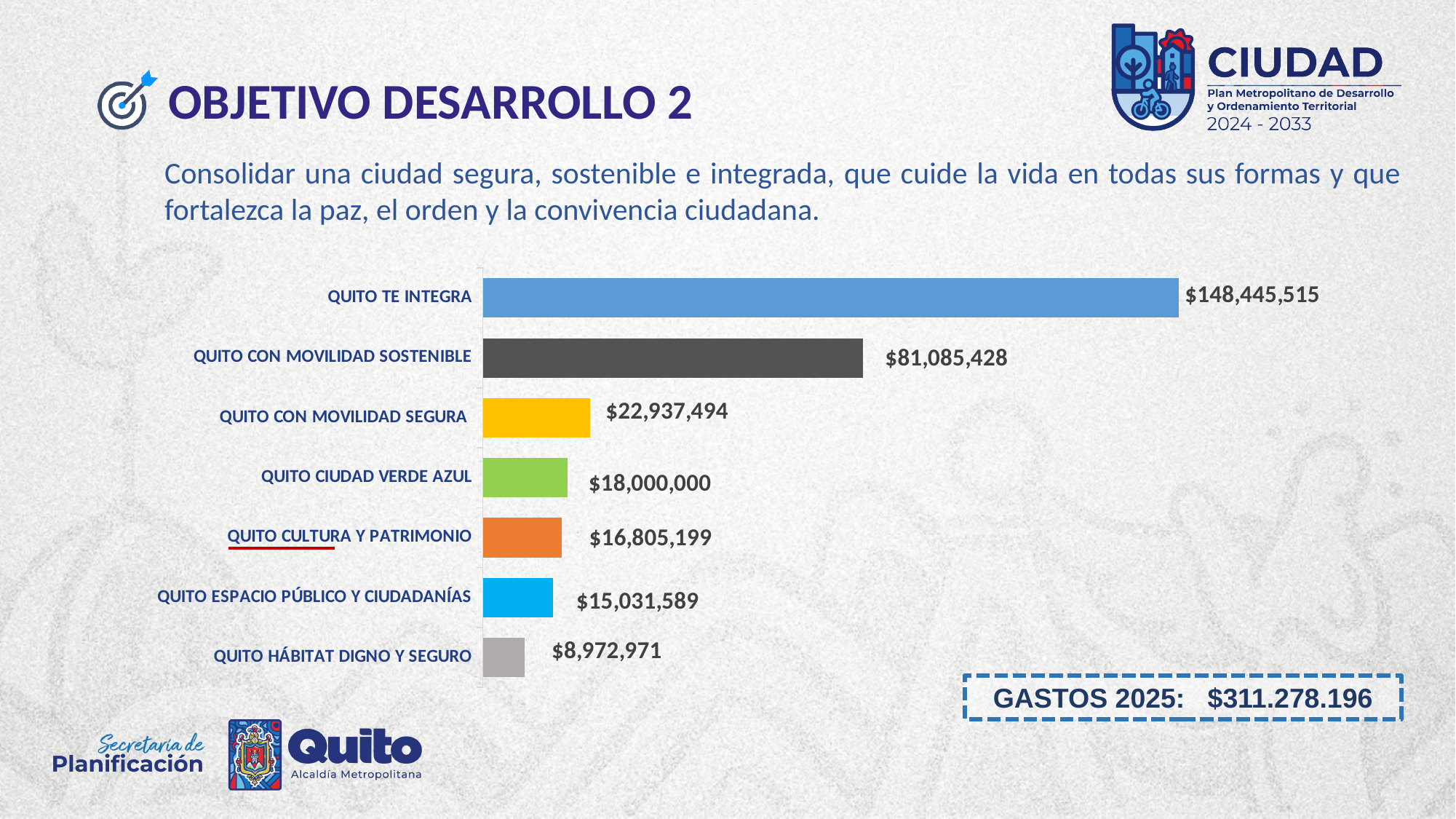
What kind of chart is shown on the slide? Bar chart What is the value for QUITO CON MOVILIDAD SOSTENIBLE? $81,085,428 Which category has the lowest value? QUITO HÁBITAT DIGNO Y SEGURO What is the value for QUITO HÁBITAT DIGNO Y SEGURO? $8,972,971 What total is shown in the GASTOS 2025 box on the slide? $311.278.196 What is the difference between the values for QUITO TE INTEGRA and QUITO CON MOVILIDAD SOSTENIBLE? $67,360,087 Which is larger, the value for QUITO CULTURA Y PATRIMONIO or the value for QUITO ESPACIO PÚBLICO Y CIUDADANÍAS? QUITO CULTURA Y PATRIMONIO Which category has the highest value? QUITO TE INTEGRA How many categories are plotted in the bar chart? 7 What is the value for QUITO TE INTEGRA? $148,445,515 What is the value for QUITO CIUDAD VERDE AZUL? $18,000,000 What is the difference between the values for QUITO CON MOVILIDAD SEGURA and QUITO CIUDAD VERDE AZUL? $4,937,494